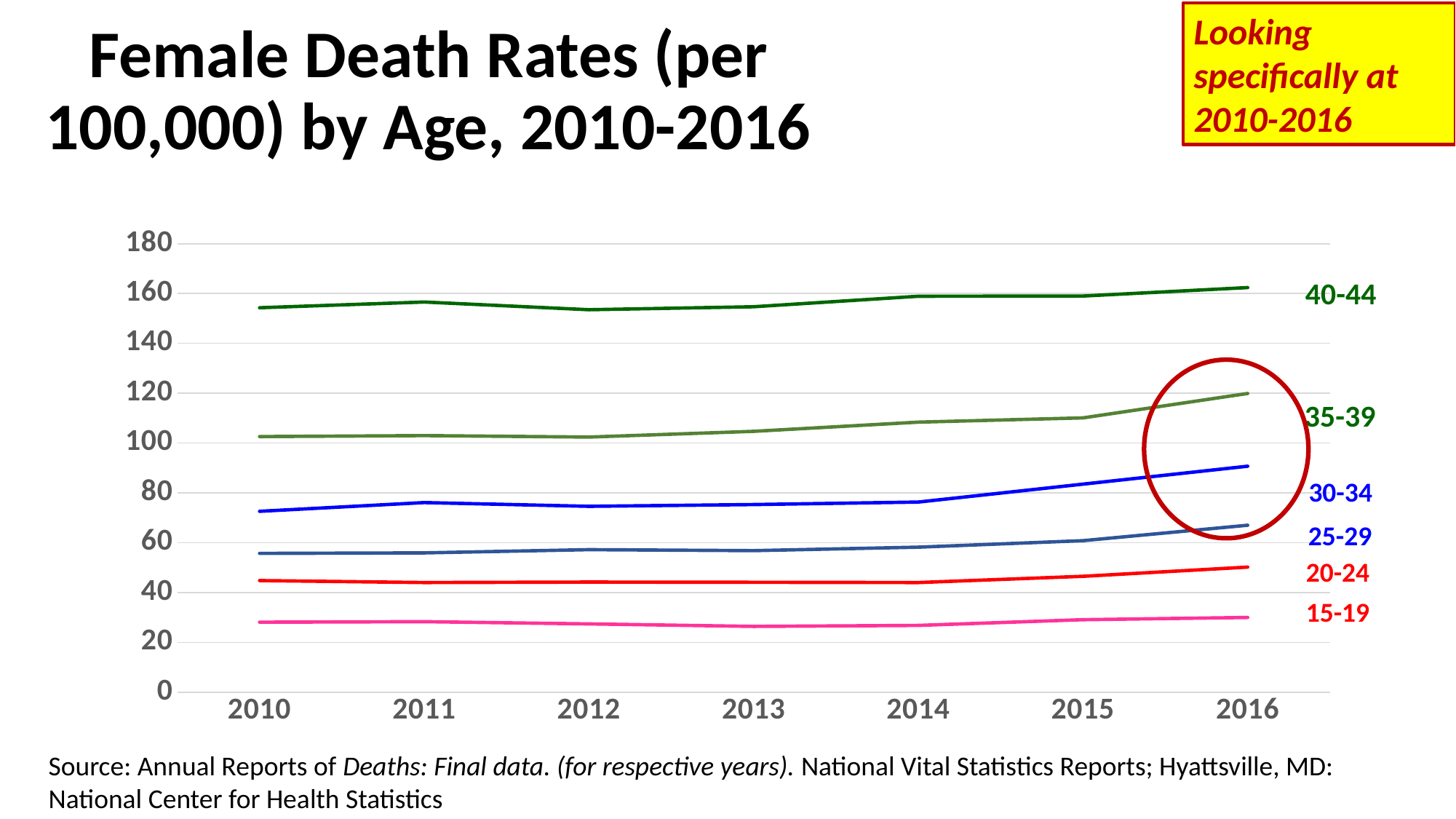
In 2016, which age group has the higher female death rate: 40-44 or 35-39? 40-44 Does the female death rate for the 30-34 age group rise or fall from 2010 to 2016? rise Is the female death rate for the 30-34 age group in 2016 greater or less than 80? greater Is the female death rate for the 25-29 age group in 2016 greater or less than 60? greater How many years are shown along the x axis? 7 Which age group has the lowest female death rate across all years shown? 15-19 Is the female death rate for the 40-44 age group in 2010 greater or less than 160? less How many age groups (series) are plotted on the chart? 6 Which age group has the highest female death rate across all years shown? 40-44 What is the title of the chart on the slide? Female Death Rates (per 100,000) by Age, 2010-2016 What kind of chart is shown on the slide? Line chart